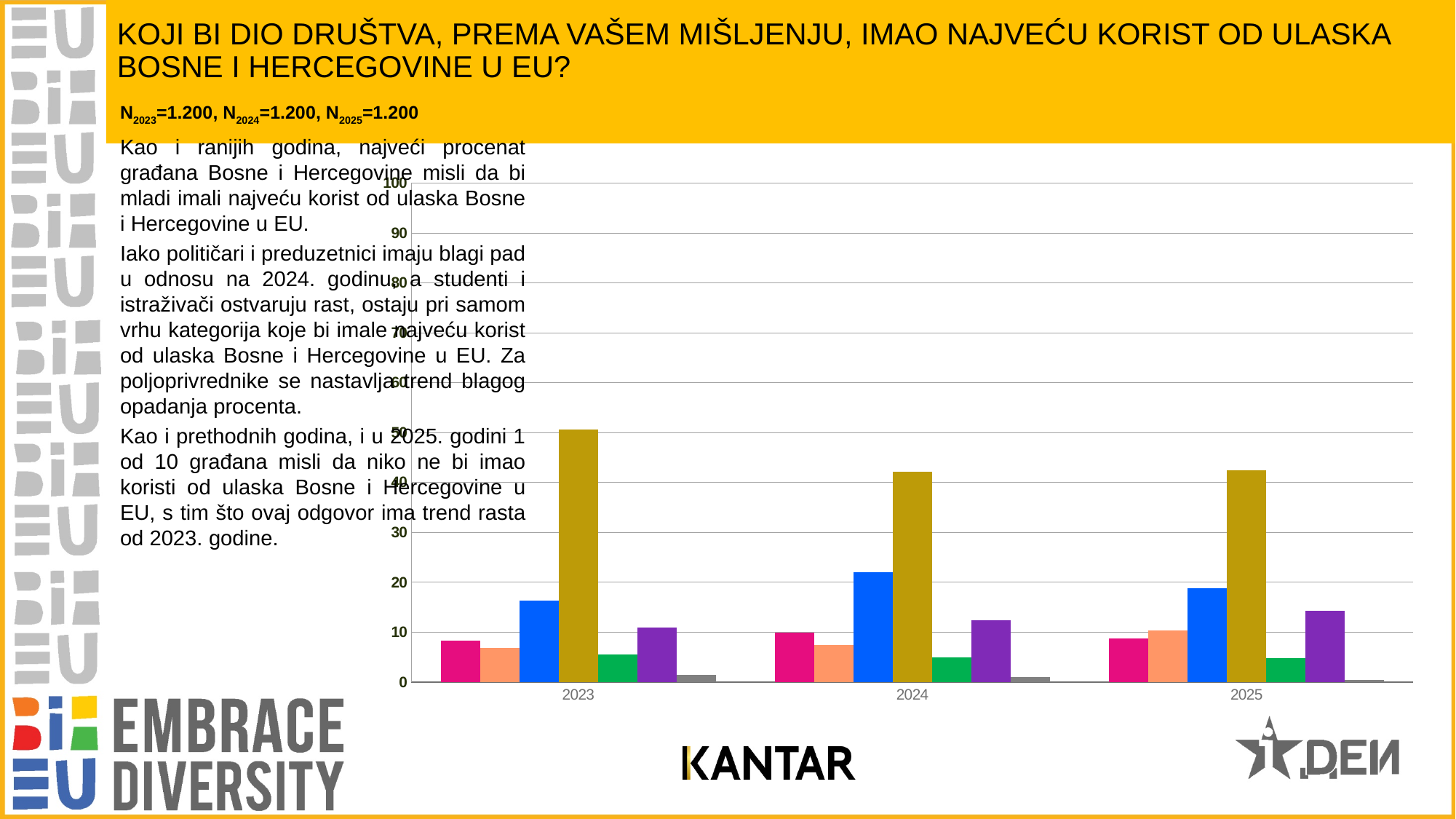
Which is larger, the gold bar for 2023 or the gold bar for 2024? 2023 Which is larger, the blue bar for 2024 or the blue bar for 2023? 2024 Is the gold bar for 2025 greater or less than 50? less How many year categories are shown on the x axis of the chart? 3 Which year has the tallest gold bar in the chart? 2023 Is the green bar for 2023 greater or less than 10? less Is the blue bar for 2023 greater or less than 20? less What kind of chart is shown on the slide? bar chart What is the highest value shown on the vertical axis of the chart? 100